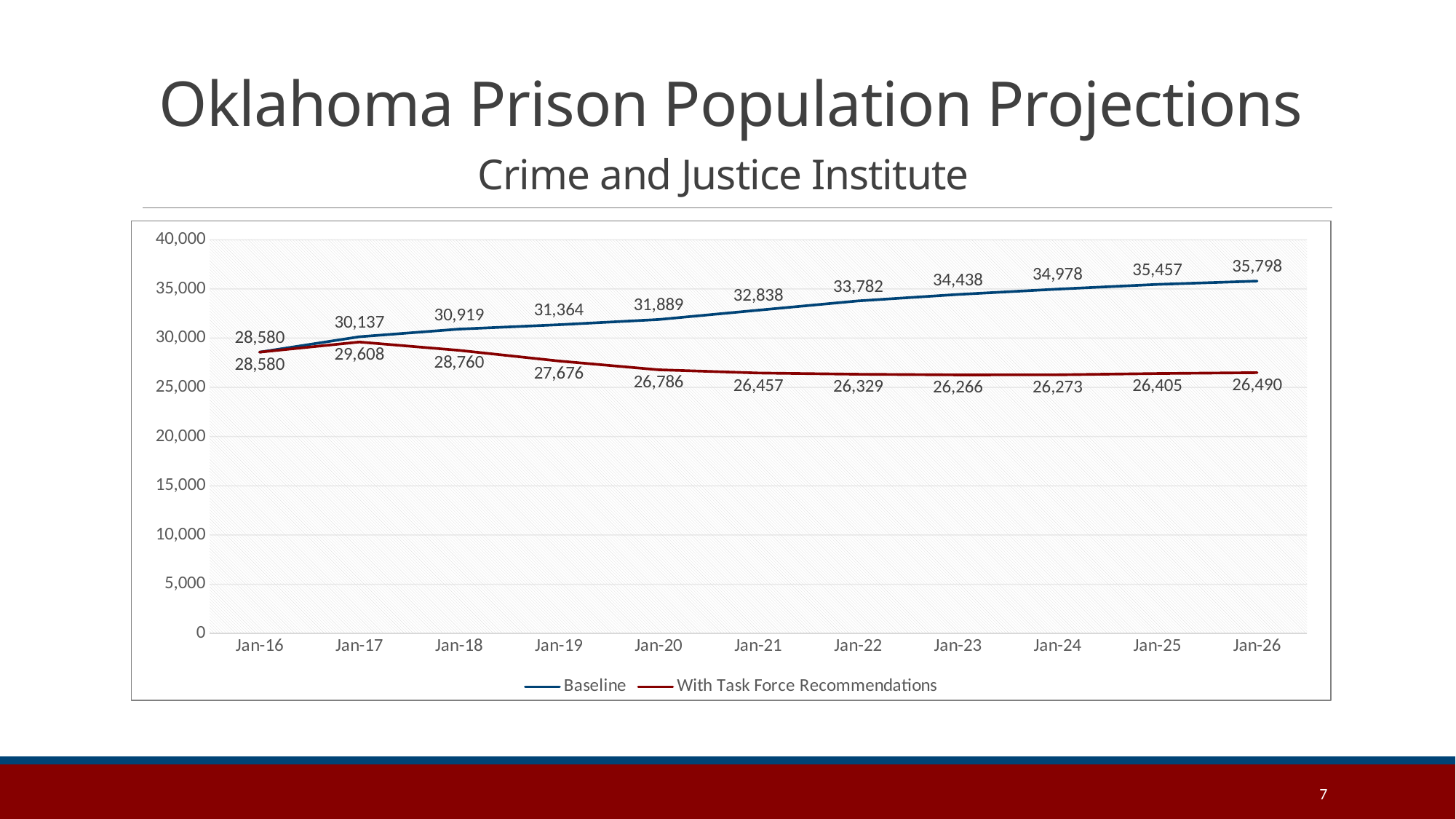
How many series does the legend list? 2 What is the difference between the Baseline and With Task Force Recommendations values in Jan-26? 9,308 What colour is the line for With Task Force Recommendations? Red What is the Baseline value for Jan-26? 35,798 Which series has the larger value in Jan-19, Baseline or With Task Force Recommendations? Baseline Does the Baseline series rise or fall from Jan-16 to Jan-26? Rise In which year does the With Task Force Recommendations series reach its lowest value? Jan-23 What kind of chart is shown on the slide? Line chart How many time points are plotted on the x axis? 11 What is the Baseline value for Jan-20? 31,889 What is the With Task Force Recommendations value for Jan-23? 26,266 In which year does the Baseline series reach its highest value? Jan-26